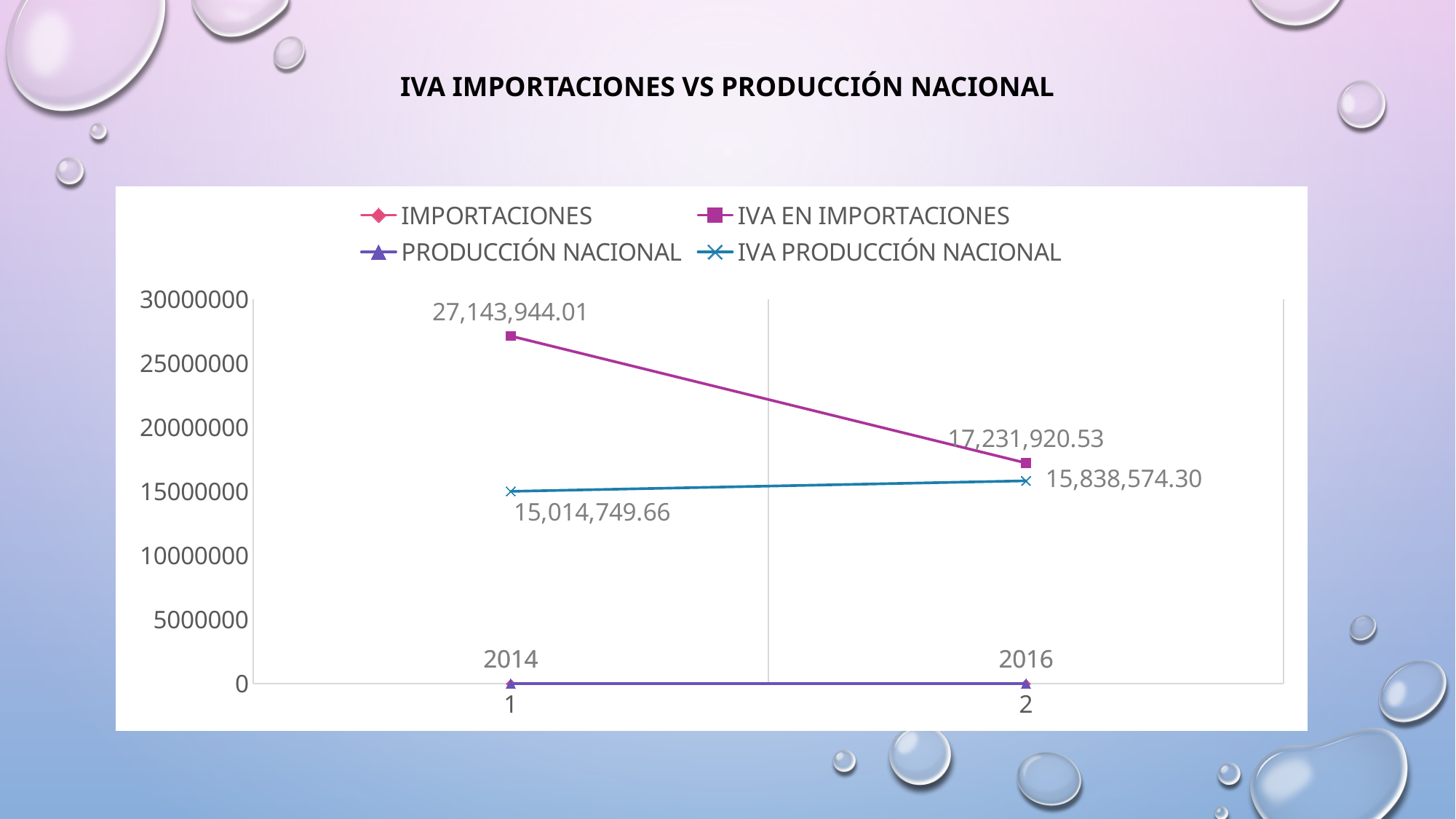
What is the value of IVA PRODUCCIÓN NACIONAL at point 1? 15,014,749.66 How many points are plotted along the x axis for each series? 2 How many series does the legend list? 4 What is the value of IVA PRODUCCIÓN NACIONAL at point 2? 15,838,574.30 What kind of chart is shown on the slide? line chart Which series has the highest plotted value on the chart? IVA EN IMPORTACIONES What is the value of IVA EN IMPORTACIONES at point 1? 27,143,944.01 What is the difference between the IVA EN IMPORTACIONES values at point 1 and point 2? 9,912,023.48 At point 2, which is larger: IVA EN IMPORTACIONES or IVA PRODUCCIÓN NACIONAL? IVA EN IMPORTACIONES What is the title of the chart? IVA IMPORTACIONES VS PRODUCCIÓN NACIONAL What is the value of IVA EN IMPORTACIONES at point 2? 17,231,920.53 Does the IVA EN IMPORTACIONES line rise or fall from point 1 to point 2? fall